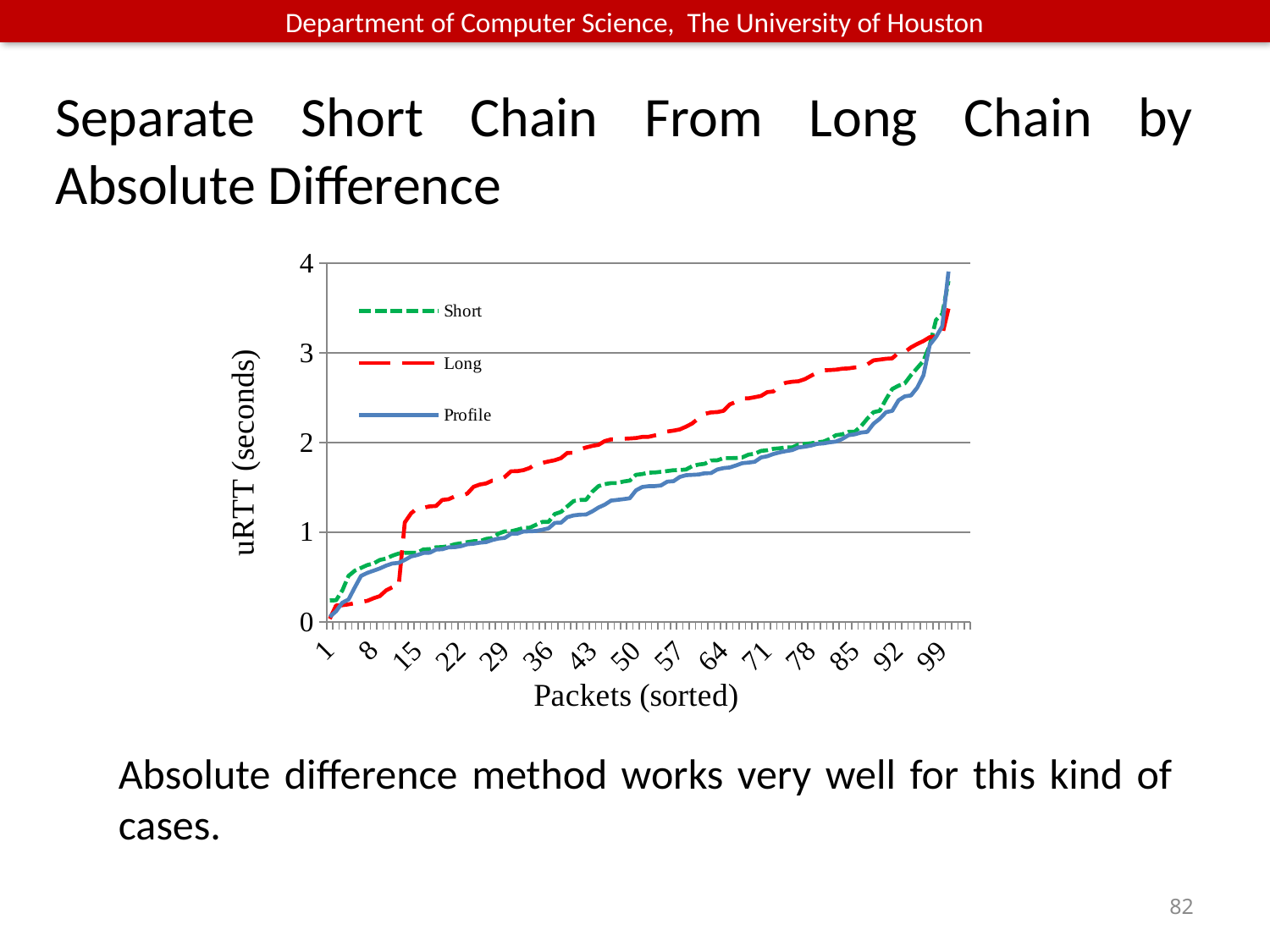
Is the value of the Short series at packet 8 greater or less than 1? less Is the value of the Profile series at packet 99 greater or less than 3? greater At packet 8, which series has the lowest value? Long What kind of chart is shown on the slide? line chart What is the label of the x axis of the chart? Packets (sorted) What is the label of the y axis of the chart? uRTT (seconds) Is the value of the Long series at packet 64 greater or less than 2? greater At packet 64, which series has the highest value? Long How many series does the chart's legend list? 3 Do the values of the Profile series rise or fall as the packet index increases along the x axis? rise At packet 50, which series has the larger value, Long or Profile? Long